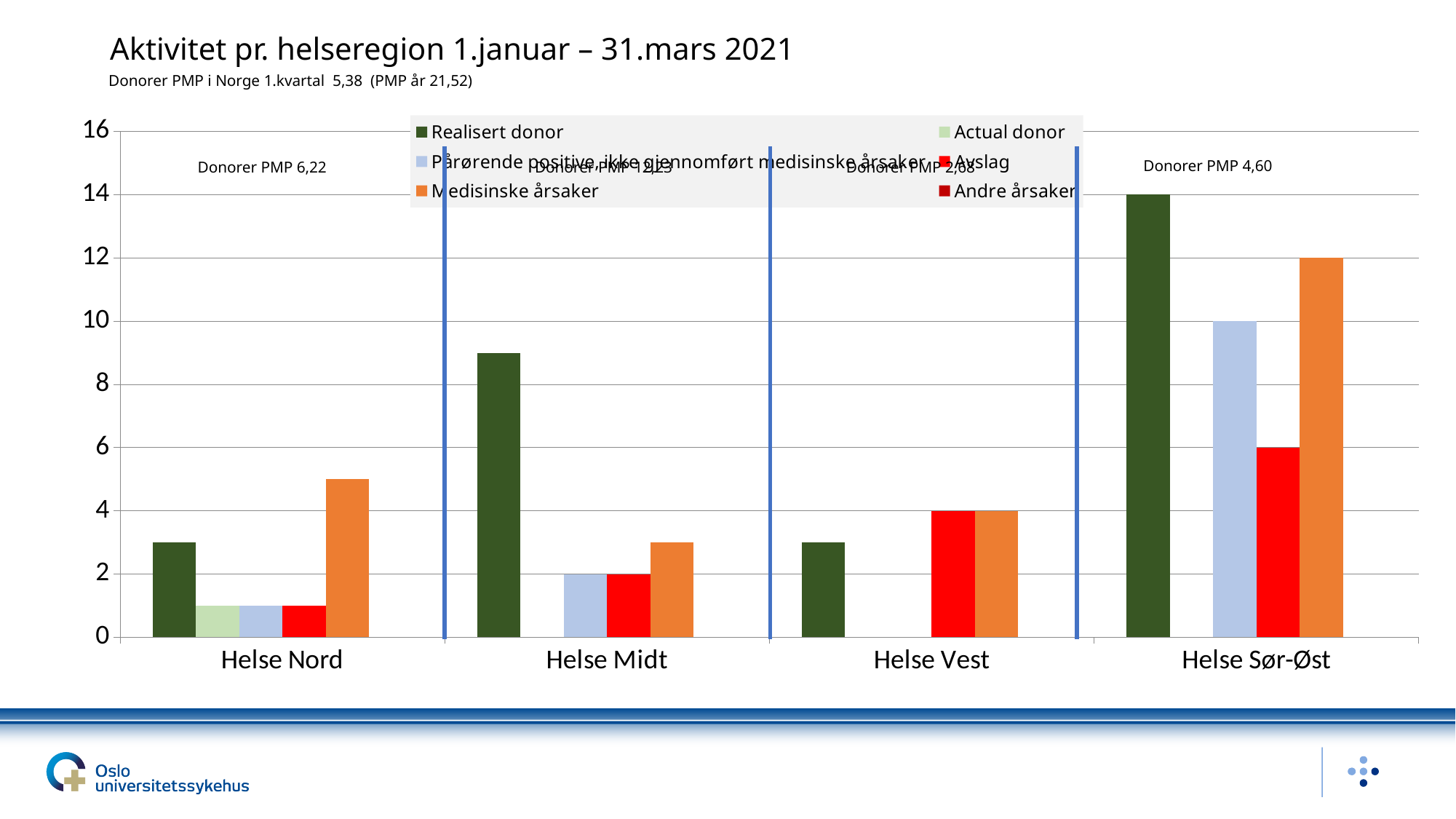
What kind of chart is shown on the slide? bar chart What is the value of Realisert donor for Helse Sør-Øst? 14 How many series does the legend list? 6 What is the Donorer PMP value shown above the Helse Nord bars? 6,22 How many health regions are shown on the x axis? 4 Is the Medisinske årsaker value for Helse Sør-Øst greater or less than 10? greater Which region has the highest Realisert donor value? Helse Sør-Øst Which region has the lowest Medisinske årsaker value? Helse Midt Which is larger for Helse Vest: Realisert donor or Avslag? Avslag